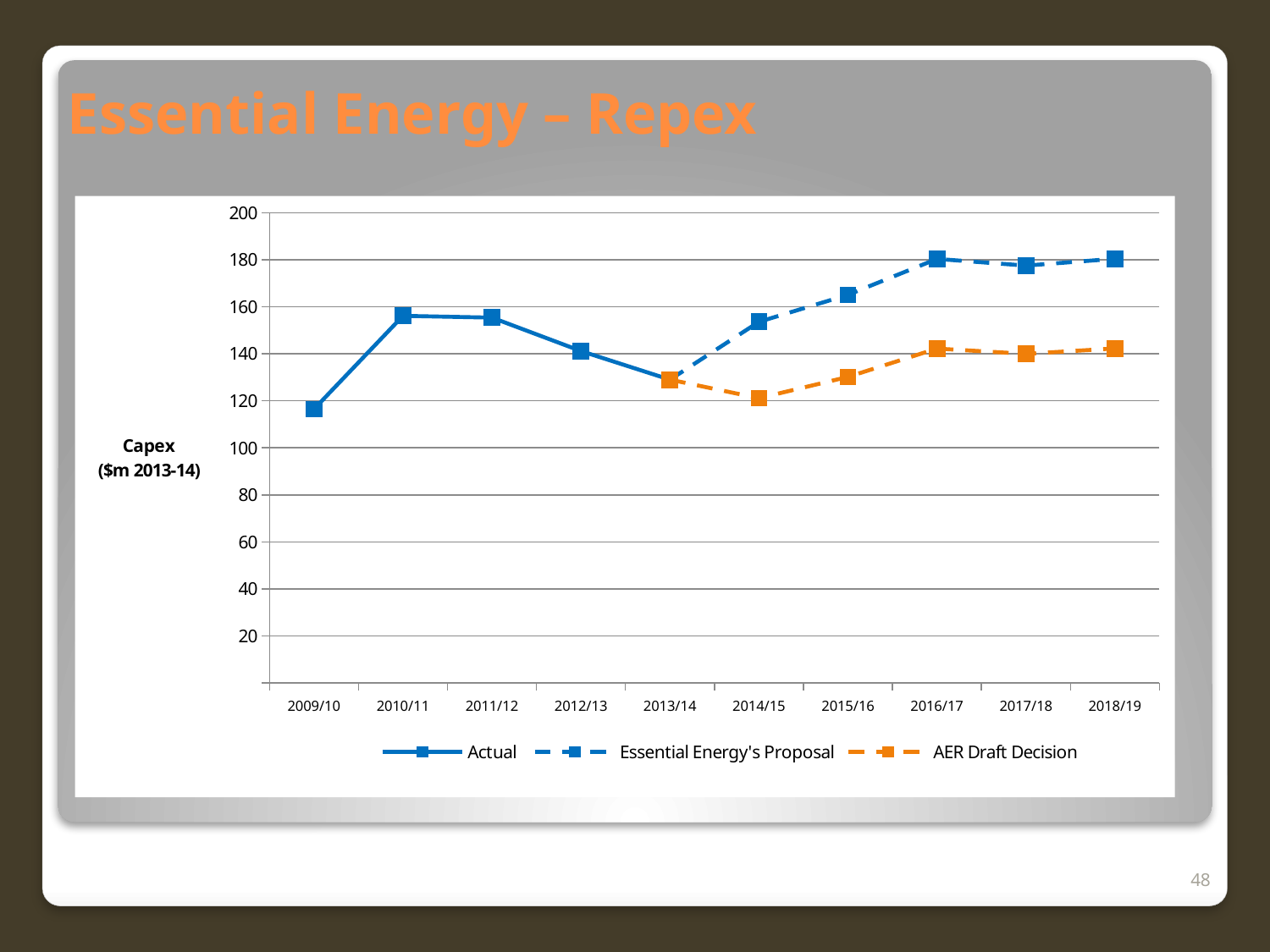
What kind of chart is shown on the slide? line chart In 2016/17, which is larger: Essential Energy's Proposal or the AER Draft Decision? Essential Energy's Proposal In which year is the AER Draft Decision series at its lowest? 2014/15 How many series does the legend list? 3 Is the AER Draft Decision value for 2014/15 greater or less than 140? less Is the Actual value for 2009/10 greater or less than 120? less In which year is the Actual series at its lowest? 2009/10 What is the label on the vertical axis of the chart? Capex ($m 2013-14) Is the Essential Energy's Proposal value for 2016/17 greater or less than 160? greater Does the Actual series rise or fall from 2010/11 to 2013/14? fall How many years are shown on the x axis? 10